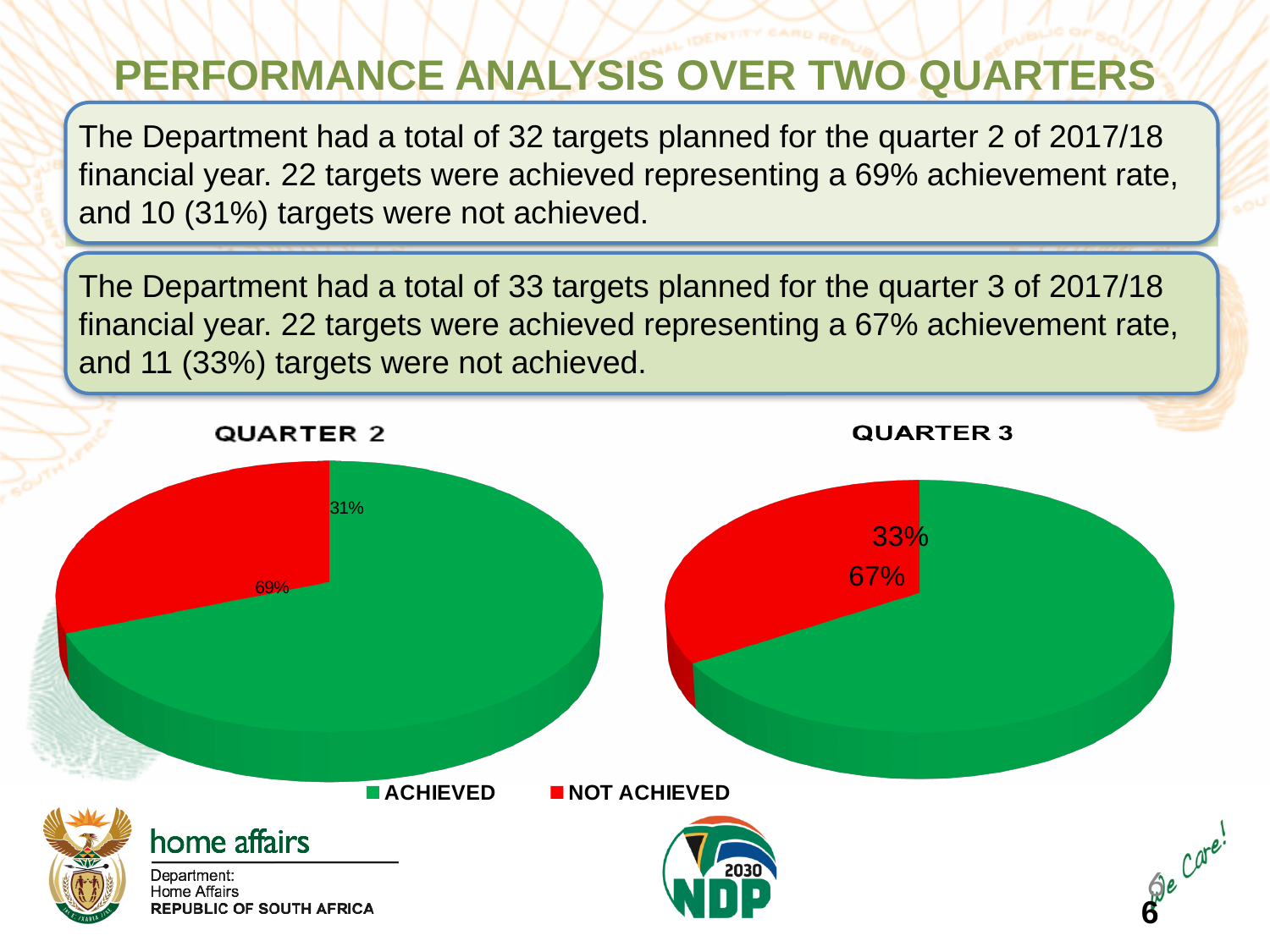
Which chart shows a larger NOT ACHIEVED share, QUARTER 2 or QUARTER 3? QUARTER 3 What colour represents NOT ACHIEVED in the pie charts? Red In the QUARTER 2 pie chart, what percentage of targets were not achieved? 31% In the QUARTER 3 pie chart, what percentage of targets were not achieved? 33% In the QUARTER 3 pie chart, what share of the pie does the ACHIEVED slice represent? 67% In the QUARTER 3 pie chart, what percentage of targets were achieved? 67% In the QUARTER 3 pie chart, which category has the smallest slice? NOT ACHIEVED In the QUARTER 2 pie chart, which category has the largest slice? ACHIEVED How many categories does the legend list for the pie charts? 2 What type of chart is used for QUARTER 2 and QUARTER 3? Pie chart In the QUARTER 2 pie chart, what is the difference in percentage points between the ACHIEVED and NOT ACHIEVED slices? 38 In the QUARTER 2 pie chart, what percentage of targets were achieved? 69%